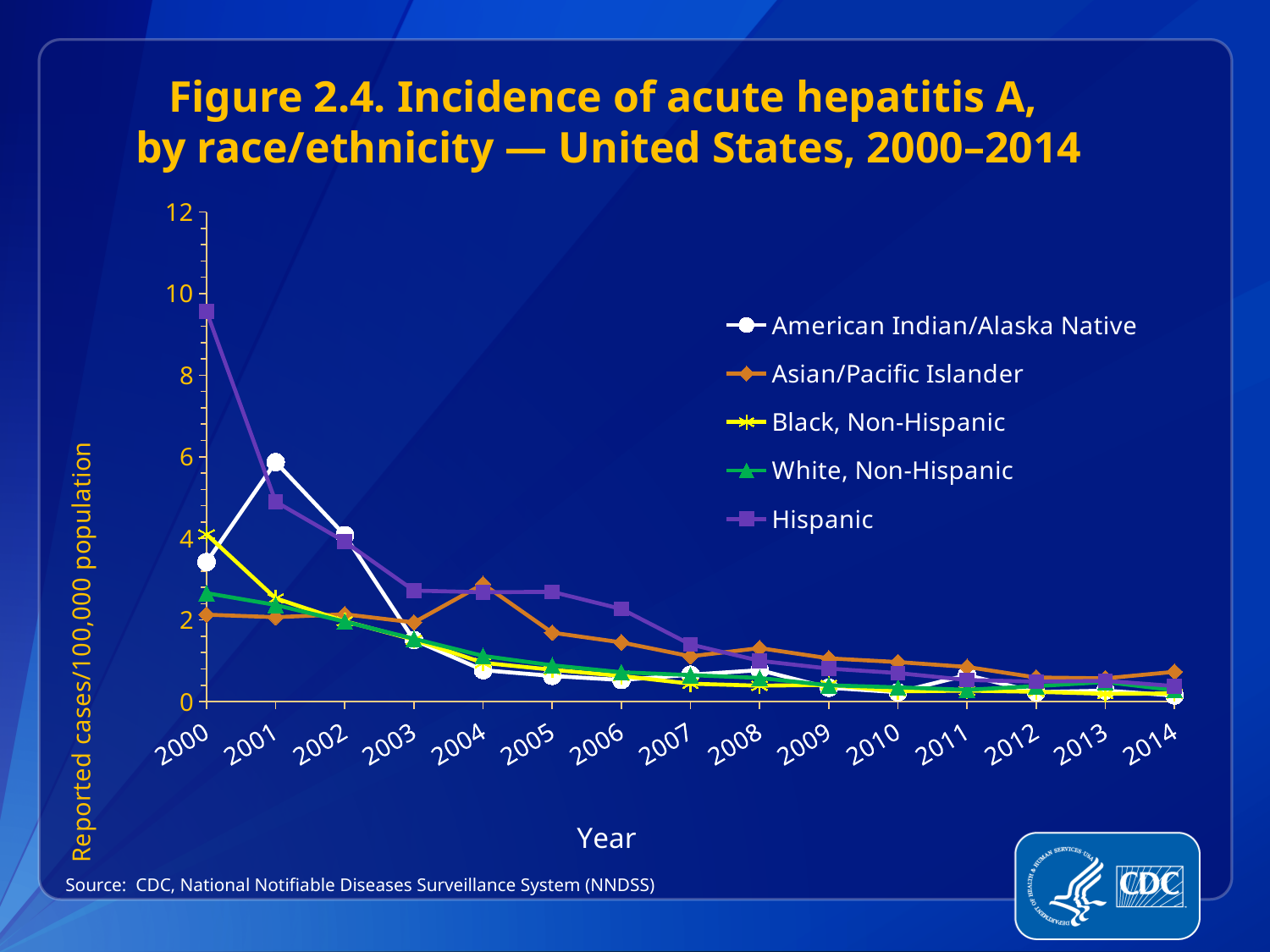
What kind of chart is shown on the slide? line chart How many years are shown along the x axis? 15 Which race/ethnicity group had the highest incidence in 2001? American Indian/Alaska Native Which race/ethnicity group had the highest incidence in 2000? Hispanic How many series does the legend list? 5 Is the value for Asian/Pacific Islander in 2014 greater or less than 2? less Does the Hispanic series generally rise or fall from 2000 to 2014? fall What is the label of the y axis? Reported cases/100,000 population Is the value for American Indian/Alaska Native in 2001 greater or less than 4? greater Is the value for Hispanic in 2000 greater or less than 8? greater In 2000, which is larger: the value for Hispanic or the value for American Indian/Alaska Native? Hispanic In 2002, which is larger: the value for American Indian/Alaska Native or the value for White, Non-Hispanic? American Indian/Alaska Native